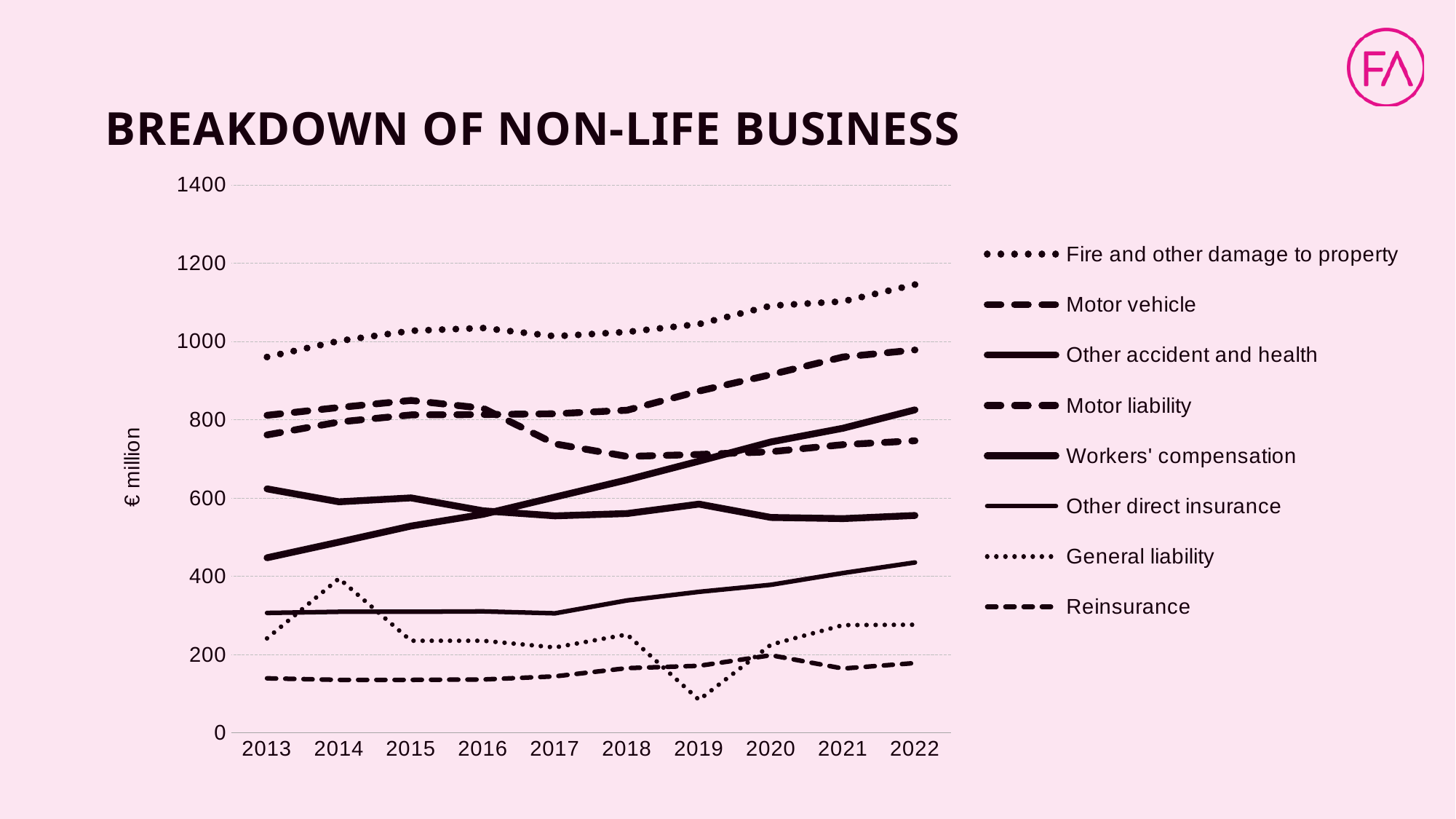
Is the value for Fire and other damage to property in 2022 greater or less than 1000? greater Which series has the lowest value in 2022? Reinsurance How many years are shown on the x axis? 10 Is the value for Reinsurance in 2013 greater or less than 200? less In 2022, which is larger: Motor vehicle or Motor liability? Motor vehicle In which year does General liability reach its lowest value? 2019 Is the value for Other accident and health in 2013 greater or less than 600? less What is the label on the y axis? € million Which series has the highest value in 2022? Fire and other damage to property How many series does the legend list? 8 Does the Other accident and health series rise or fall from 2013 to 2022? Rises What kind of chart is shown on the slide? Line chart